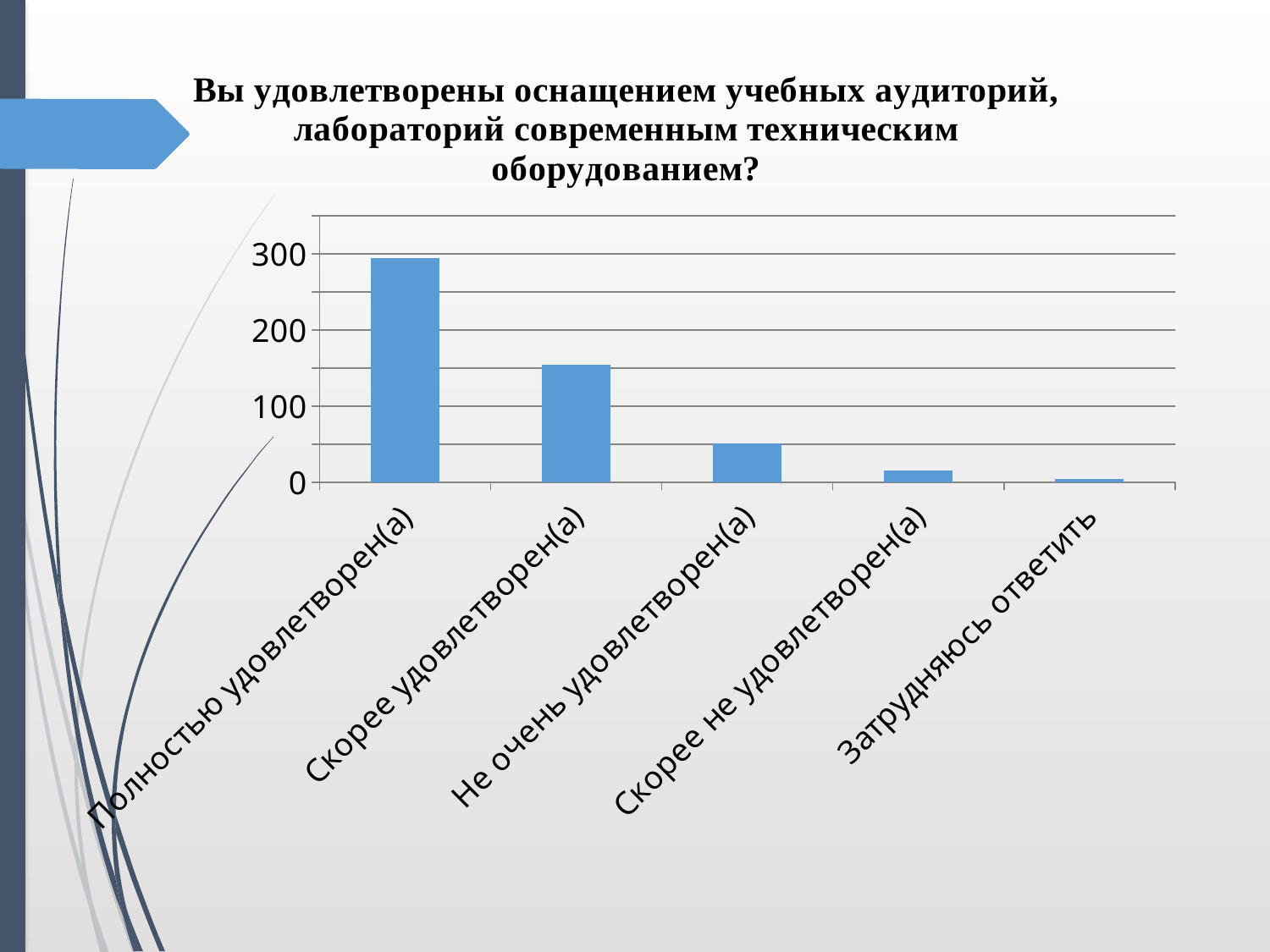
Is the value for Не очень удовлетворен(а) greater or less than 100? less Is the value for Скорее не удовлетворен(а) greater or less than 100? less Which category has the highest bar? Полностью удовлетворен(а) Which is larger, the value for Скорее удовлетворен(а) or the value for Не очень удовлетворен(а)? Скорее удовлетворен(а) What kind of chart is shown on the slide? bar chart Is the value for Скорее удовлетворен(а) greater or less than 100? greater How many categories are shown on the x axis of the chart? 5 Do the bar values rise or fall from left to right along the x axis? fall What is the title of the chart? Вы удовлетворены оснащением учебных аудиторий, лабораторий современным техническим оборудованием? Which category has the lowest bar? Затрудняюсь ответить